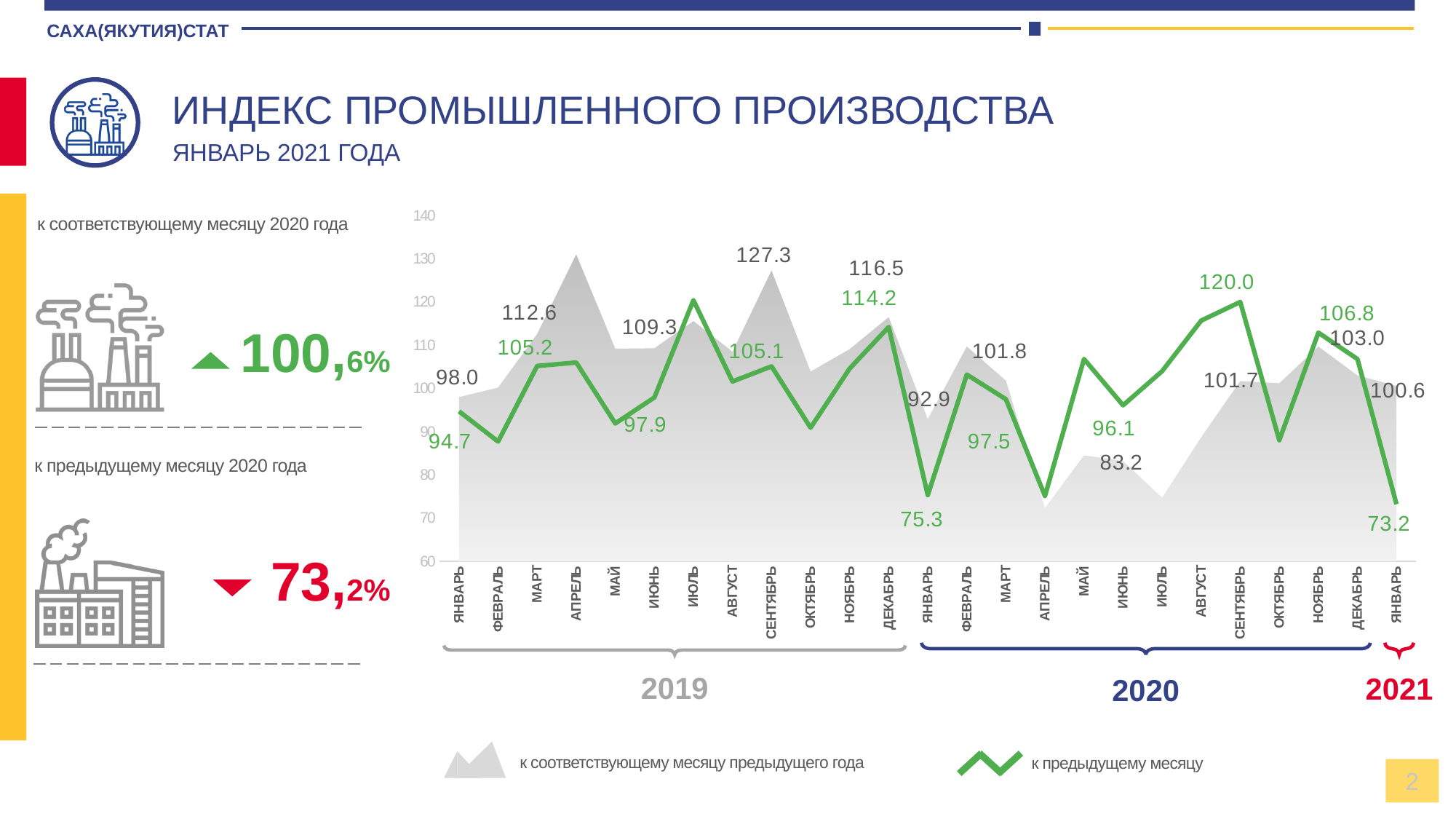
For Январь 2021, what is the difference between the grey area value and the green line value? 27.4 For Ноябрь 2020, which is larger: the green line value or the grey area value? The green line How many months are shown along the x axis of the chart? 25 What kind of chart is shown on the slide? A combined area and line chart How many series does the chart legend list? 2 What is the value of the green line (к предыдущему месяцу) for Январь 2021? 73.2 What is the value of the green line for Январь 2020? 75.3 What is the value of the grey area (к соответствующему месяцу предыдущего года) for Январь 2021? 100.6 Is the grey area value for Апрель 2019 greater or less than 120? greater In which month does the green line reach its lowest value? Январь 2021 What is the value of the green line for Сентябрь 2020? 120.0